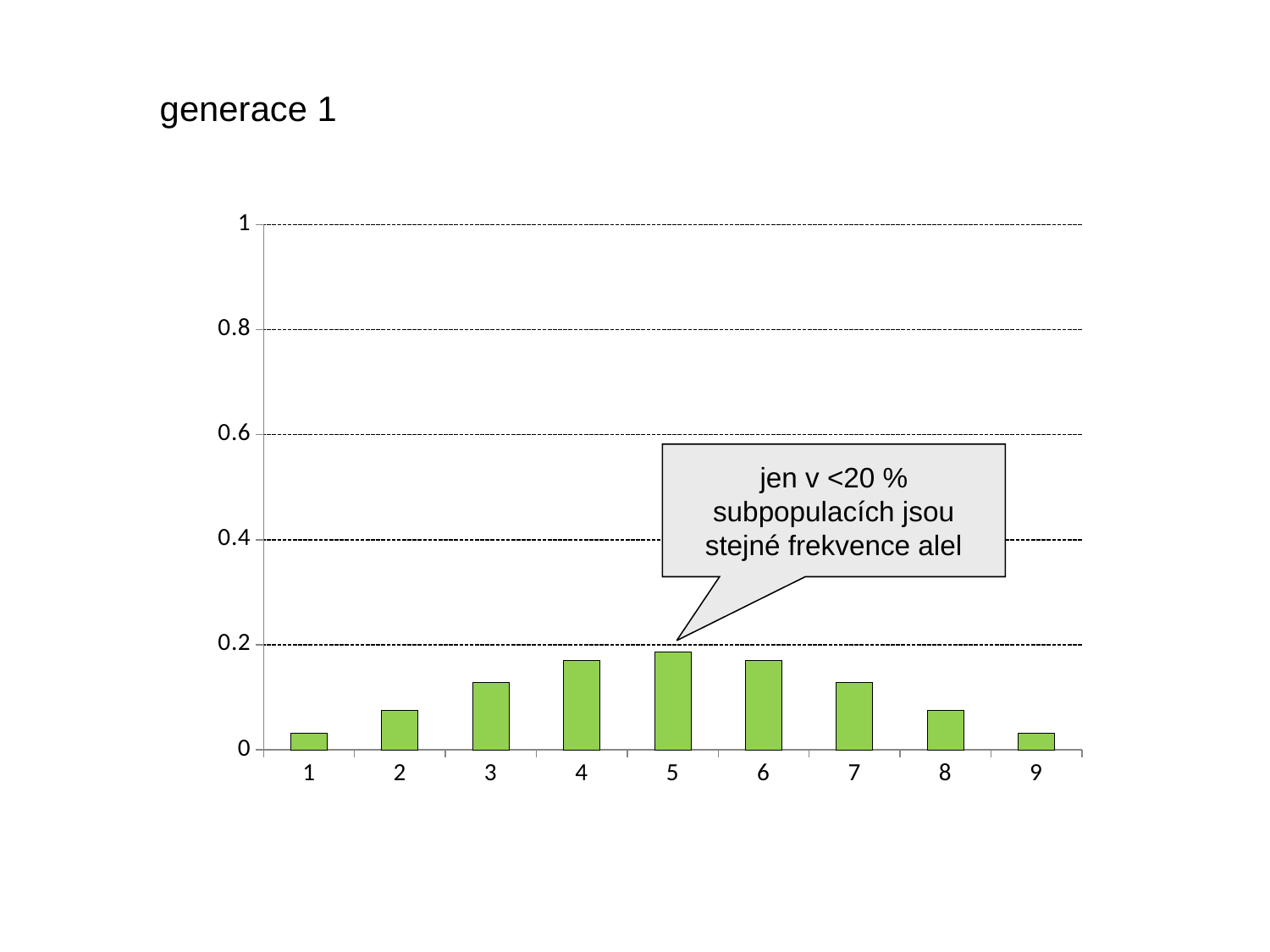
How many categories are shown on the x axis of the chart? 9 Is the value for category 1 greater or less than 0.2? less Which is larger, the value for category 7 or the value for category 9? 7 Which is larger, the value for category 2 or the value for category 4? 4 Which category has the highest bar in the chart? 5 What is the title text shown above the chart on the slide? generace 1 Is the value for category 4 greater or less than 0.4? less Which is larger, the value for category 5 or the value for category 1? 5 Do the bar values rise or fall from category 1 to category 5? rise Is the value for category 5 greater or less than 0.2? less What kind of chart is shown on the slide? bar chart Do the bar values rise or fall from category 5 to category 9? fall